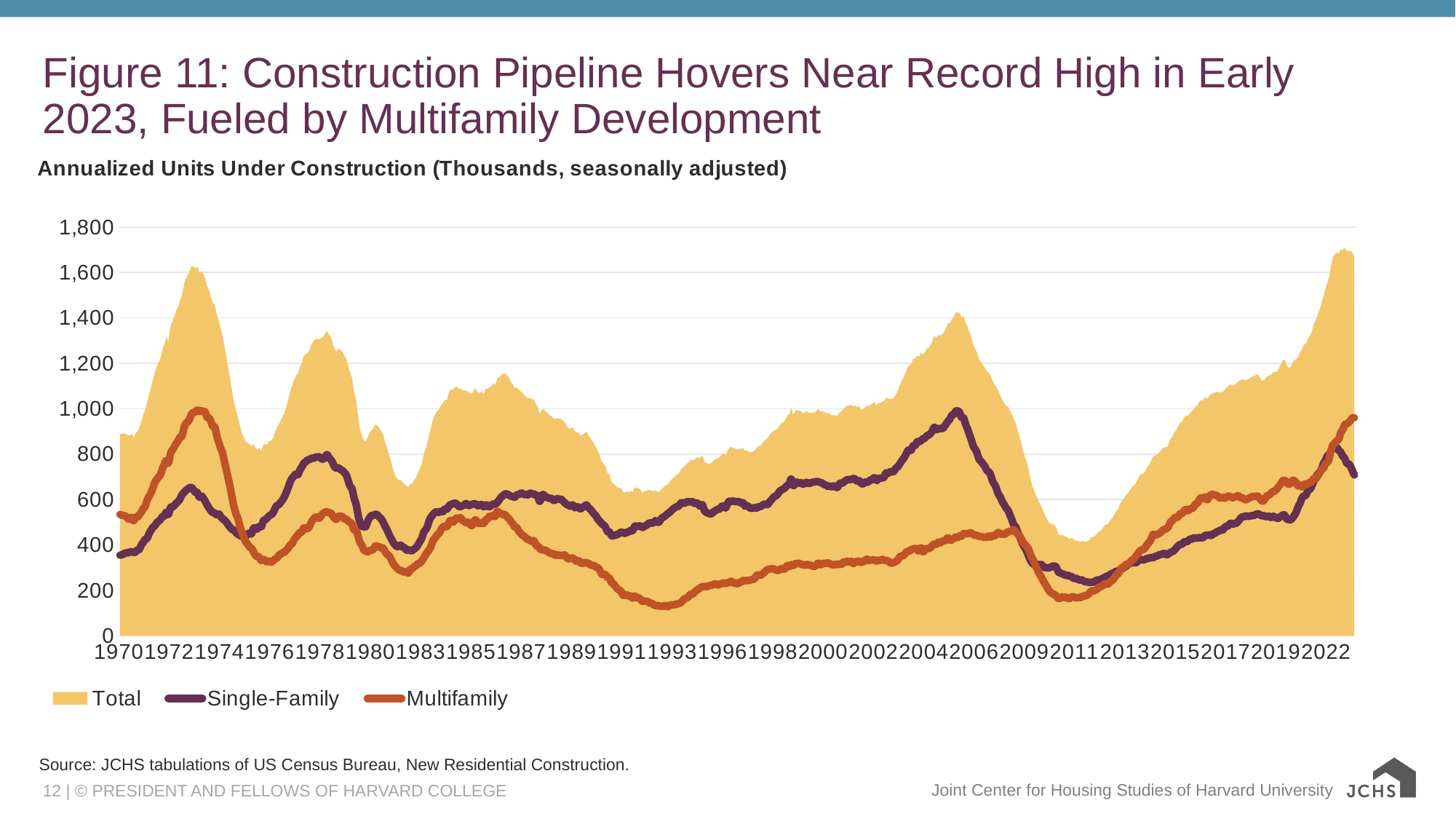
What kind of chart is this? area chart with line series Around 1973, which is larger: Single-Family or Multifamily? Multifamily Which series is drawn as a shaded area rather than a line? Total Is the value of the Total series around 2011 greater or less than 600? less What is the highest value shown on the y axis? 1,800 Is the value of the Multifamily series at the right end of the chart (2022) greater or less than 800? greater Does the Total series rise or fall between 2011 and 2022? rise How many series does the legend list? 3 Is the value of the Single-Family series around 2011 greater or less than 400? less Around 2005, which is larger: Single-Family or Multifamily? Single-Family